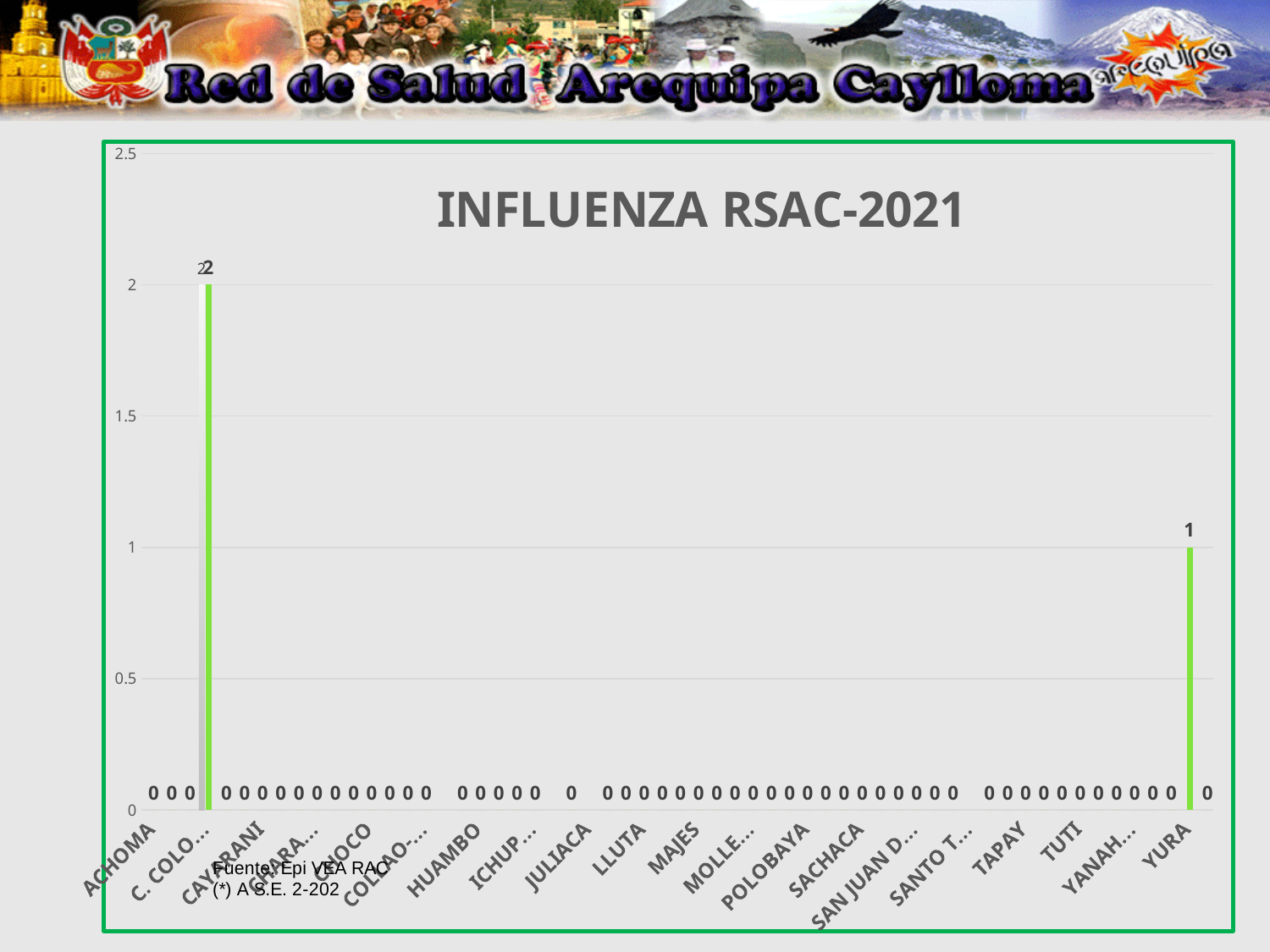
What is the difference between the two non-zero bar values in the chart? 1 What is the value for ACHOMA? 0 Is the value of the tallest bar greater or less than 1.5? greater What is the lowest value shown in the chart? 0 What is the highest value shown by any bar in the chart? 2 What type of chart is shown on the slide? bar chart What is the highest tick value shown on the vertical axis? 2.5 How many bars in the chart have a value greater than 0? 3 What is the title of the chart? INFLUENZA RSAC-2021 What is the value for MAJES? 0 What is the value for TUTI? 0